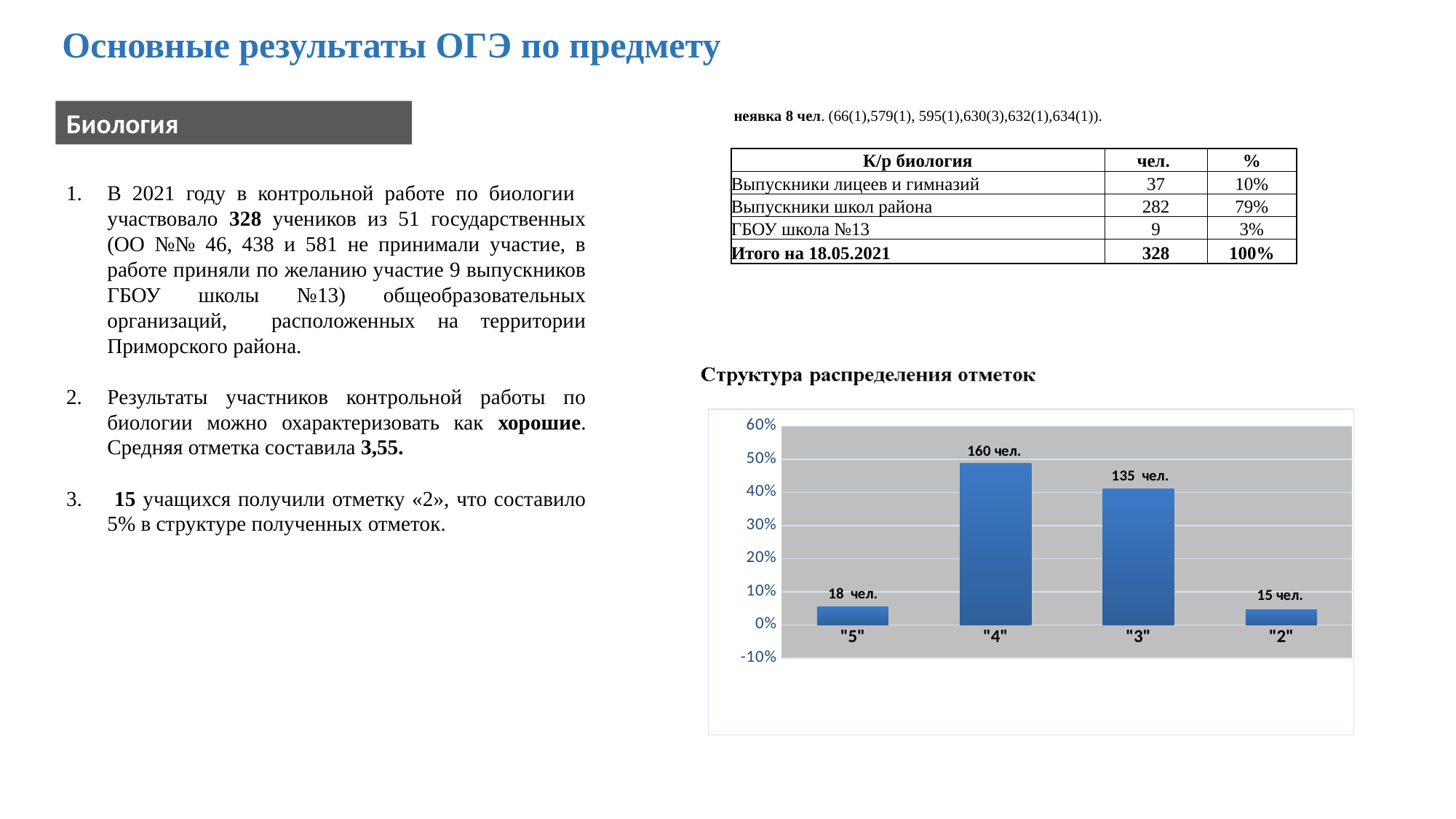
How many categories (grades) are shown on the x axis of the chart? 4 What is the data label on the bar for grade "2"? 15 чел. What is the data label on the bar for grade "5"? 18 чел. What kind of chart is shown under the title "Структура распределения отметок"? bar chart By how many people does the count for grade "4" exceed the count for grade "3"? 25 Is the value for grade "4" greater or less than 40%? greater What is the title of the chart on the slide? Структура распределения отметок Which grade has the lowest bar in the chart? "2" Which grade has the highest bar in the chart? "4" What is the data label on the bar for grade "3"? 135 чел. What is the data label on the bar for grade "4"? 160 чел. Is the value for grade "5" greater or less than 10%? less